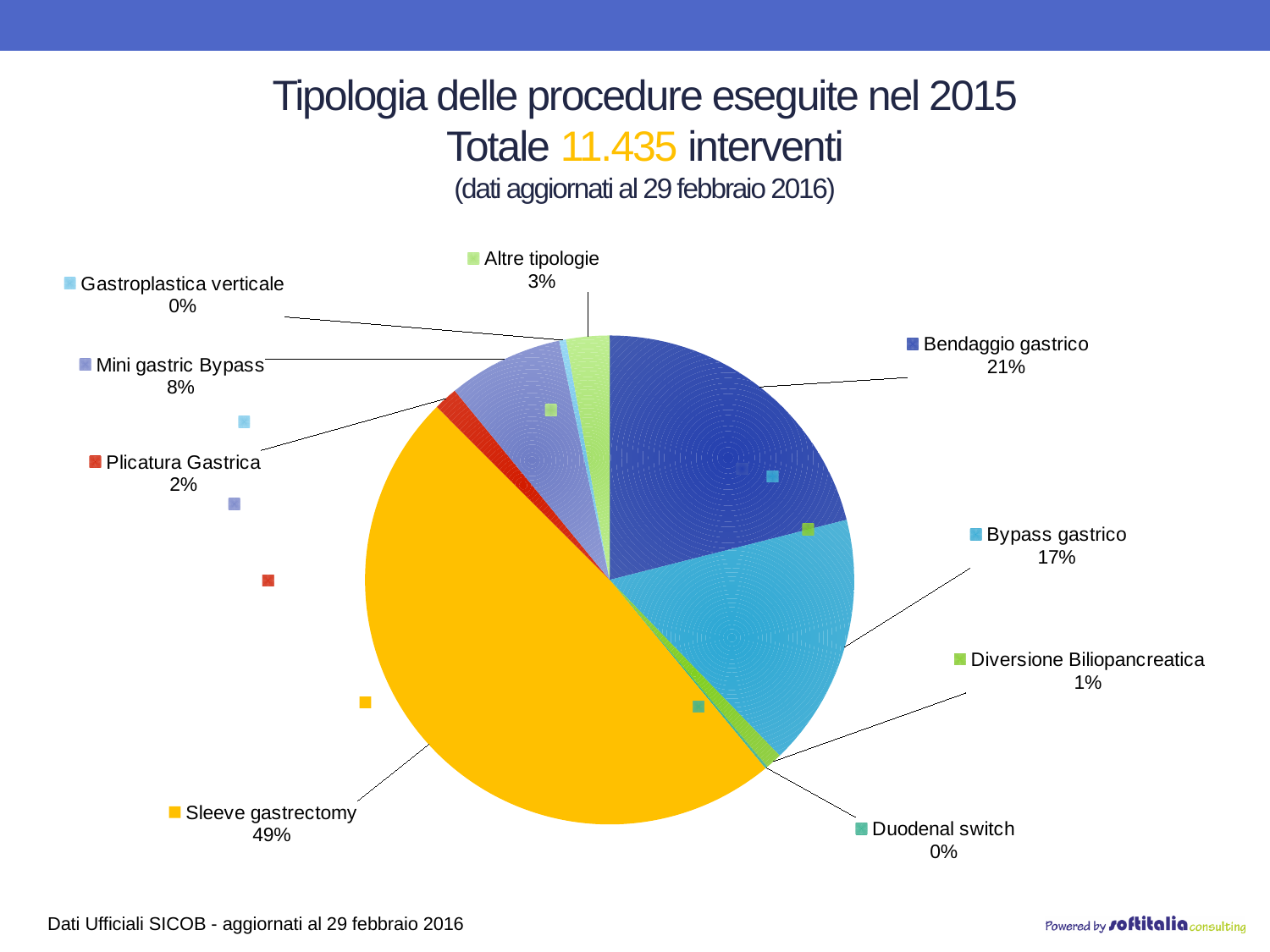
What percentage is shown for Bypass gastrico? 17% What kind of chart is shown on the slide? Pie chart What is the difference in percentage points between Bendaggio gastrico and Bypass gastrico? 4 How many procedure categories are shown in the pie chart? 9 What percentage is shown for Bendaggio gastrico? 21% Which has a larger share, Mini gastric Bypass or Plicatura Gastrica? Mini gastric Bypass According to the slide title, what is the total number of interventions in 2015? 11.435 What share of the pie does Sleeve gastrectomy represent? 49% What percentage is shown for Mini gastric Bypass? 8% What percentage is shown for Altre tipologie? 3% Which procedure type has the largest share of the pie? Sleeve gastrectomy What percentage is shown for Diversione Biliopancreatica? 1%